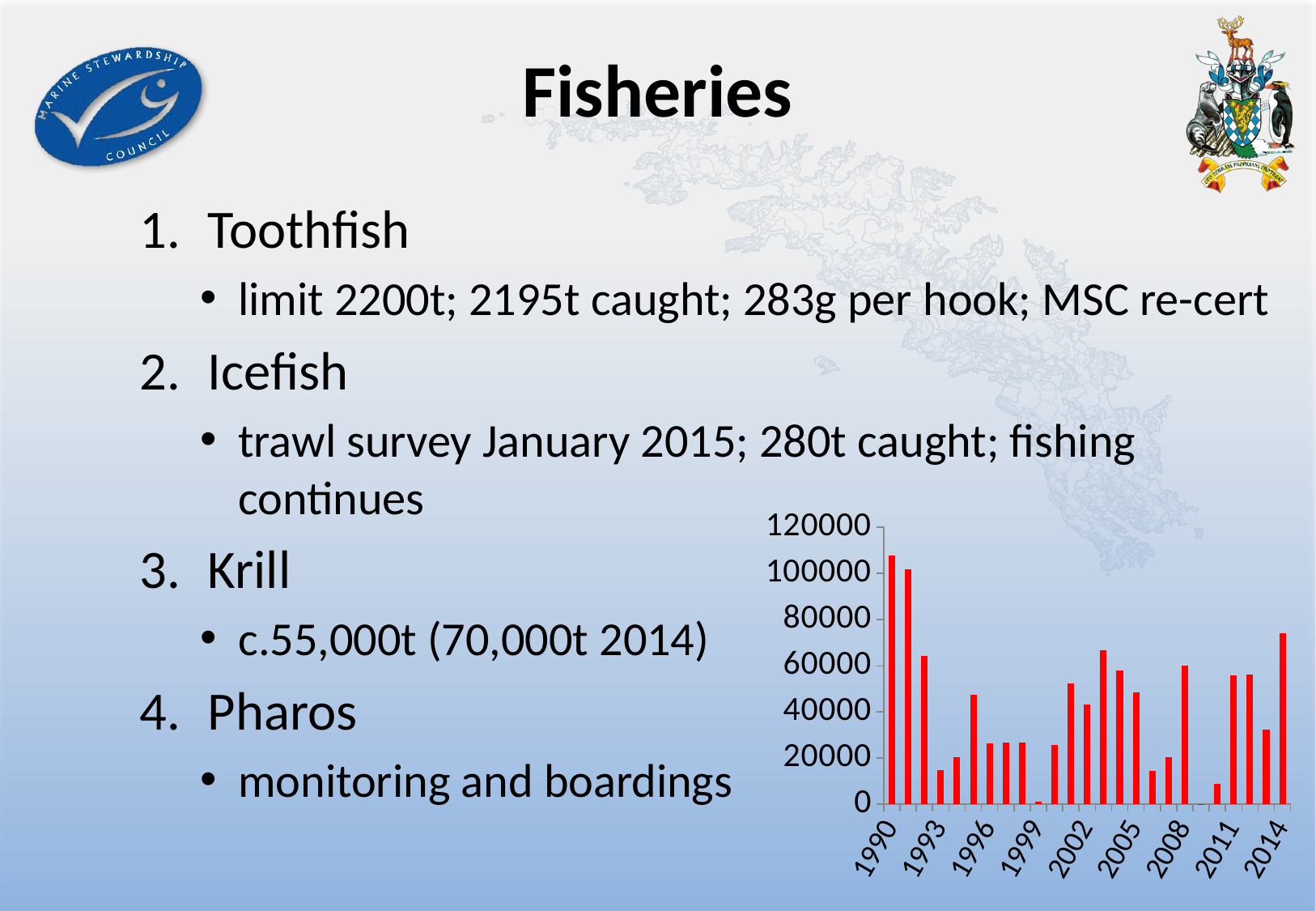
Do the values rise or fall from 1990 to 1993? fall What colour are the bars in the chart? red Is the value for 2014 greater or less than 60000? greater Which is larger, the value for 1990 or the value for 2014? 1990 Is the value for 2008 greater or less than 40000? greater Which is larger, the value for 1996 or the value for 2014? 2014 What kind of chart is shown on the slide? bar chart Is the value for 1993 greater or less than 20000? less Which year has the highest bar in the chart? 1990 What is the highest value shown on the vertical axis of the chart? 120000